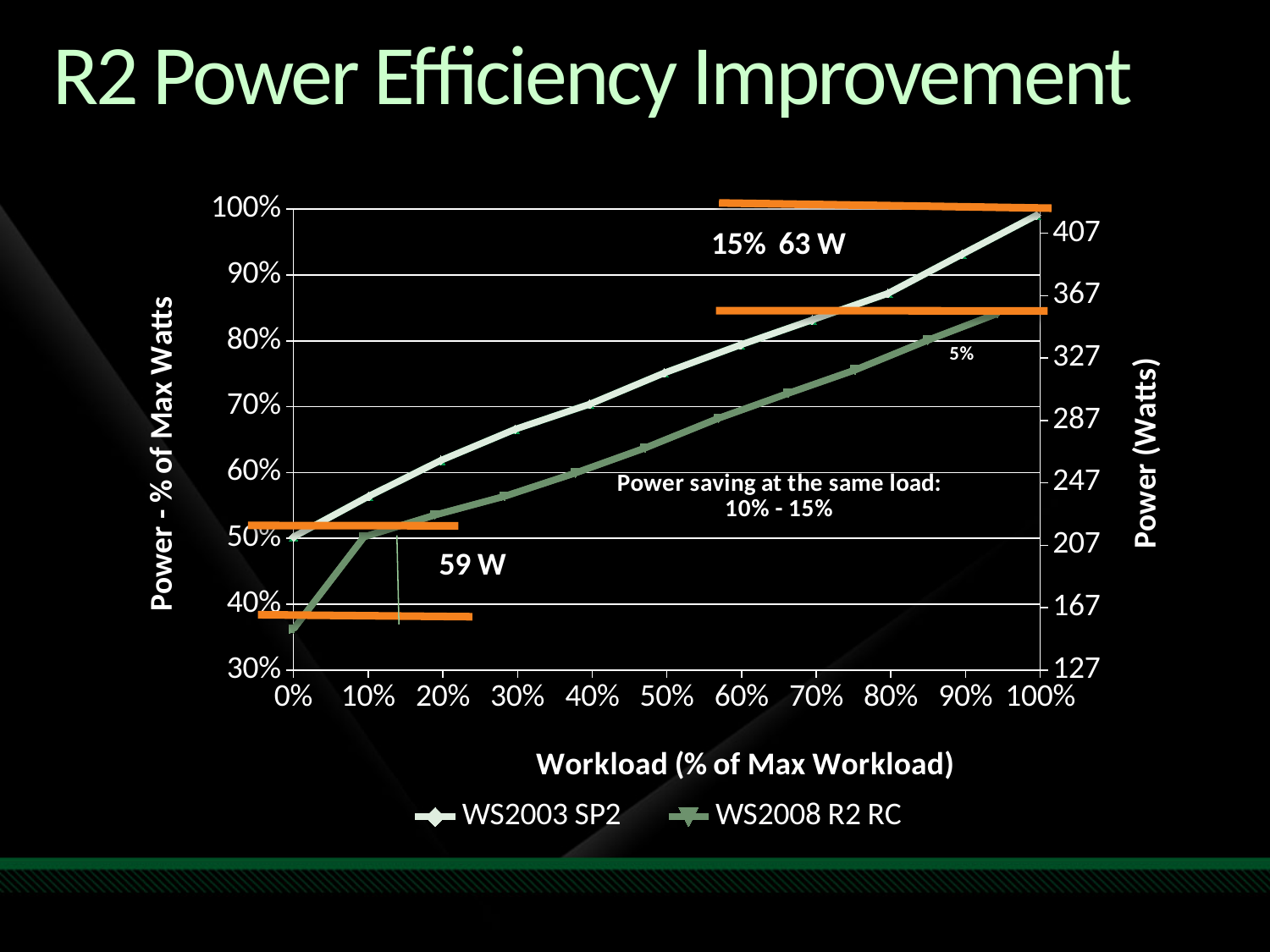
At 50% workload, which series has the higher power value, WS2003 SP2 or WS2008 R2 RC? WS2003 SP2 What is the title of the x axis? Workload (% of Max Workload) How many workload tick labels are shown along the x axis? 11 Is the value for WS2003 SP2 at 30% workload greater or less than 60% on the left axis? greater What kind of chart is shown on the slide? line chart Is the value for WS2008 R2 RC at 0% workload greater or less than 40% on the left axis? less Is the value for WS2008 R2 RC at 100% workload greater or less than 80% on the left axis? greater What are the two series named in the legend? WS2003 SP2 and WS2008 R2 RC How many series does the legend list? 2 Do the values for WS2008 R2 RC rise or fall as workload increases from 0% to 100%? rise